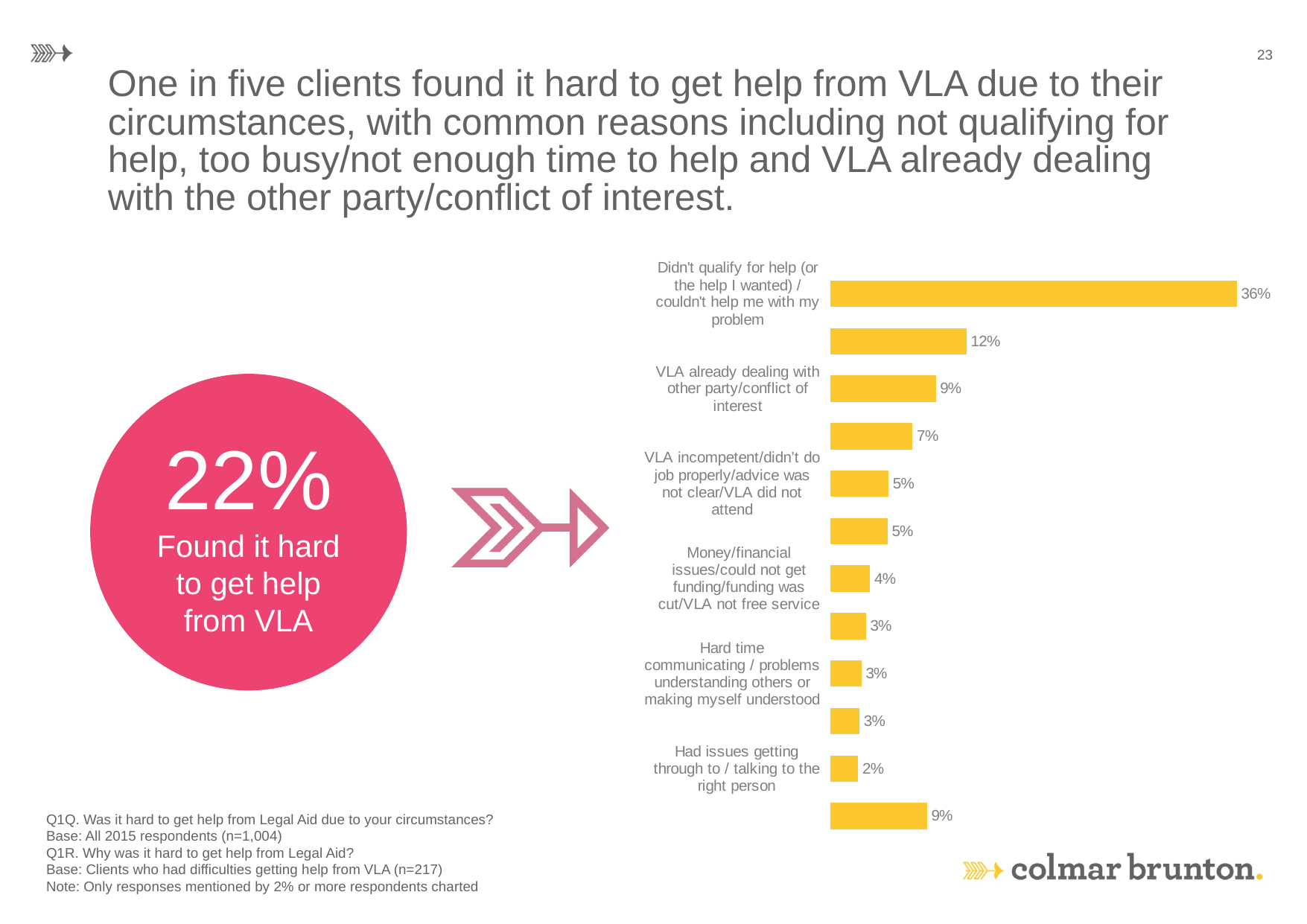
What percentage of clients cited VLA already dealing with the other party/conflict of interest? 9% What percentage of clients cited money/financial issues/could not get funding/funding was cut/VLA not free service? 4% How many bars are plotted in the chart? 12 Which labelled reason has the lowest percentage in the bar chart? Had issues getting through to / talking to the right person What colour are the bars in the chart? Yellow Which is larger: the percentage for 'VLA incompetent/didn't do job properly' or for 'Hard time communicating / problems understanding others'? VLA incompetent/didn't do job properly/advice was not clear/VLA did not attend What type of chart is used to show the reasons it was hard to get help from VLA? Bar chart What percentage of clients said they didn't qualify for help (or the help they wanted) / VLA couldn't help with their problem? 36% What is the difference in percentage points between 'Didn't qualify for help' and 'VLA already dealing with other party/conflict of interest'? 27 What percentage of clients found it hard to get help from VLA, as shown in the pink circle? 22% Which reason has the highest percentage in the bar chart? Didn't qualify for help (or the help I wanted) / couldn't help me with my problem What percentage of clients said they had issues getting through to / talking to the right person? 2%